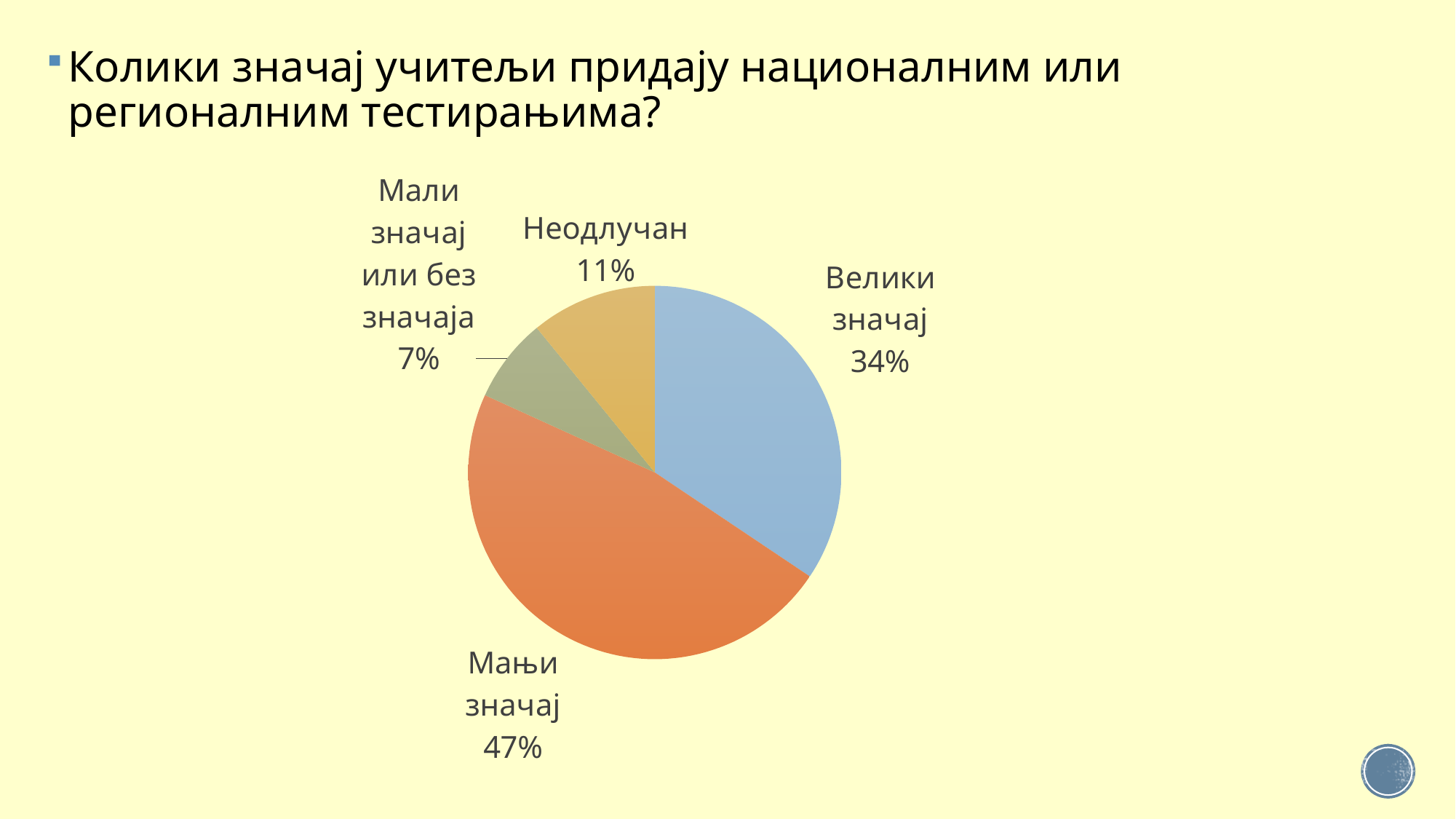
Which category has the largest slice of the pie? Мањи значај What colour is the slice for "Мањи значај"? orange Which is larger, the slice for "Неодлучан" or the slice for "Мали значај или без значаја"? Неодлучан What is the difference in percentage points between "Мањи значај" and "Велики значај"? 13% Which category has the smallest slice of the pie? Мали значај или без значаја What share of the pie does "Мали значај или без значаја" represent? 7% What kind of chart is shown on the slide? pie chart What share of the pie does "Неодлучан" represent? 11% What share of the pie does "Мањи значај" represent? 47% What is the combined share of "Велики значај" and "Неодлучан"? 45% How many slices does the pie chart have? 4